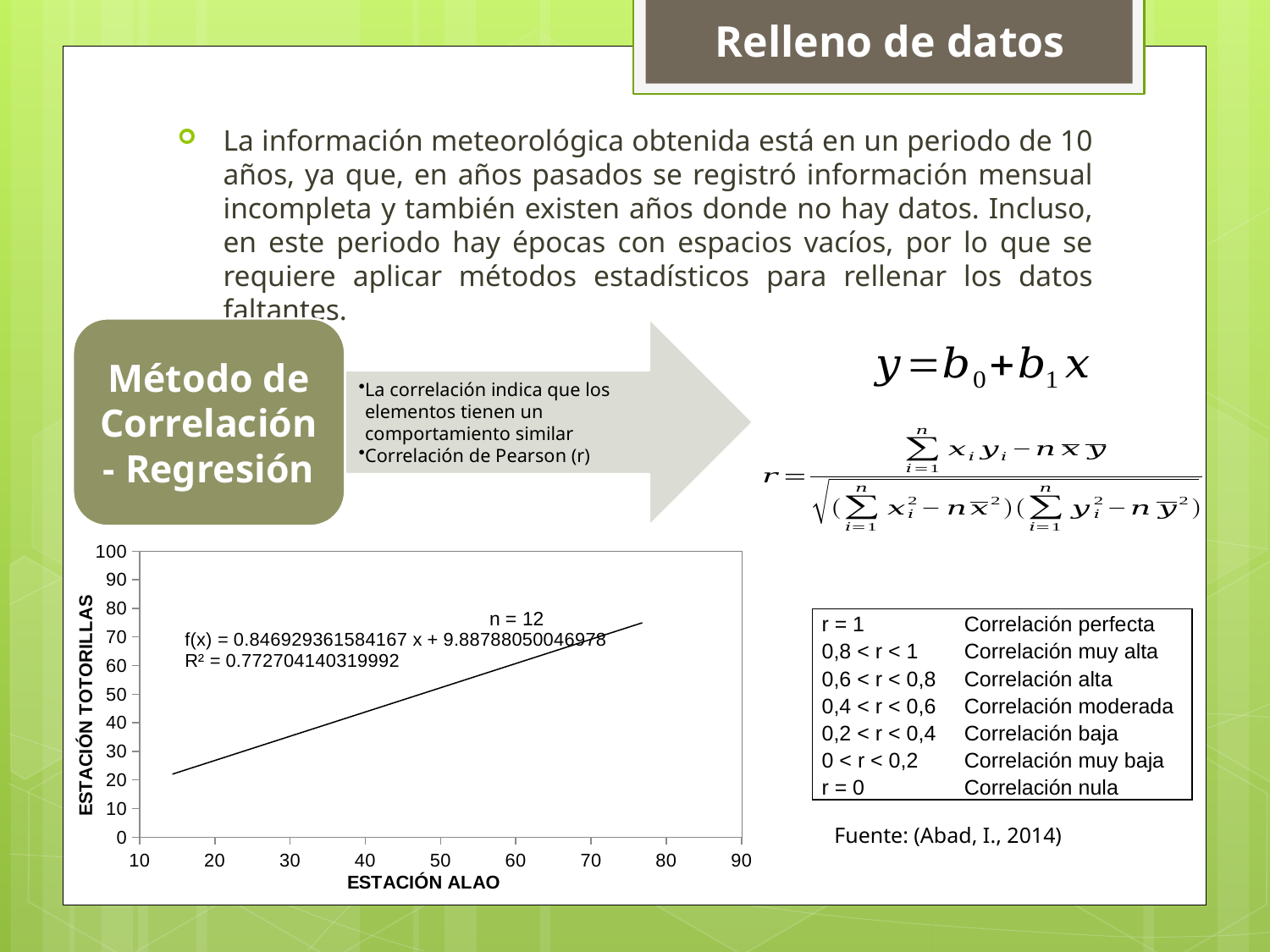
What is the maximum value shown on the y axis of the chart? 100 What is the slope of the fitted line shown on the chart? 0.846929361584167 Is the value of the fitted line at ESTACIÓN ALAO = 20 greater or less than 30? less What is the fitted equation f(x) shown on the chart? f(x) = 0.846929361584167 x + 9.88788050046978 What is the y-axis title of the chart? ESTACIÓN TOTORILLAS Does the fitted line rise or fall as ESTACIÓN ALAO increases? rise What R² value is printed on the chart? 0.772704140319992 Is the value of the fitted line at ESTACIÓN ALAO = 50 greater or less than 40? greater What is the intercept of the fitted line shown on the chart? 9.88788050046978 What is the value of n shown on the chart? n = 12 What is the x-axis title of the chart? ESTACIÓN ALAO